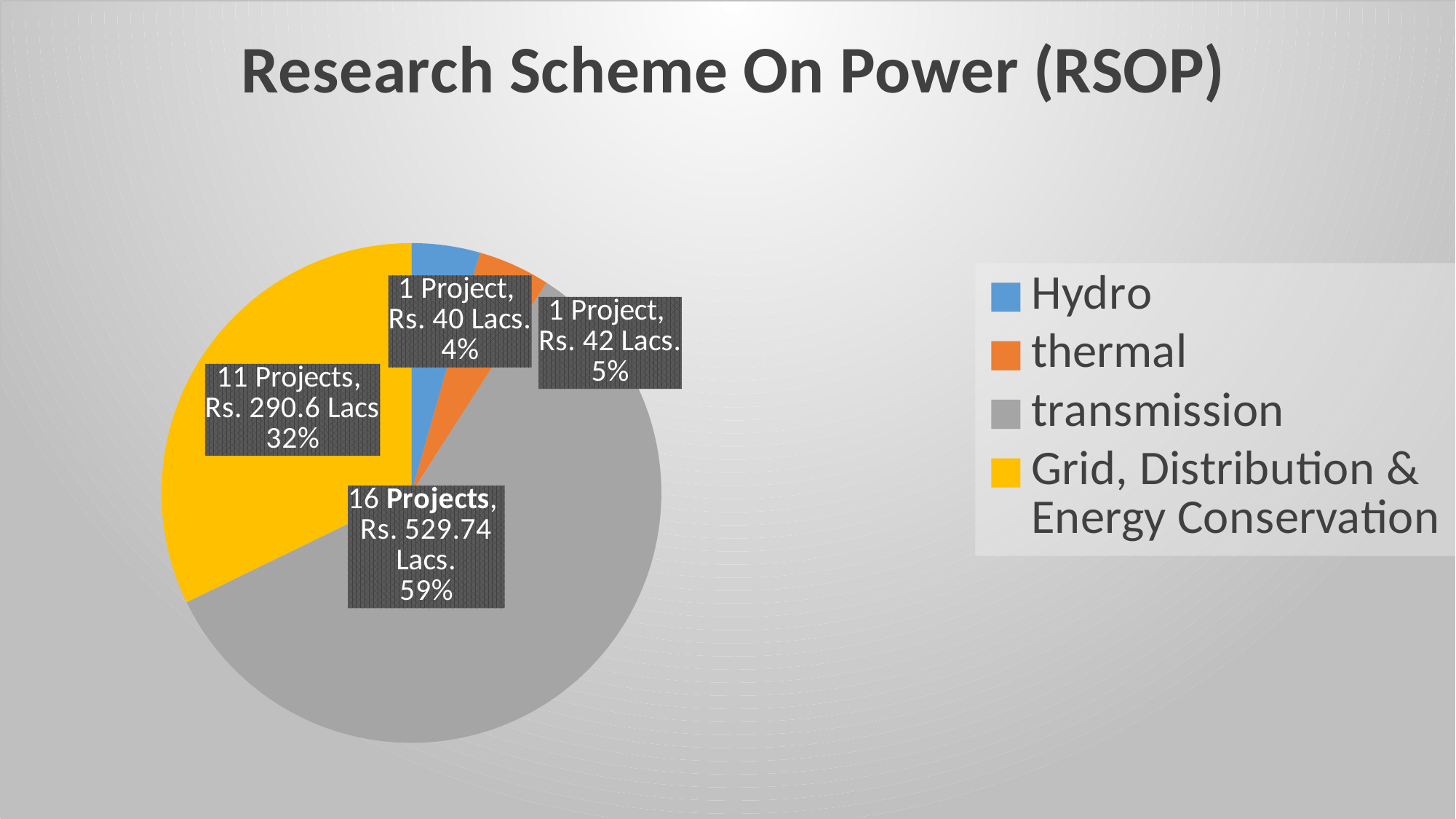
What is the title of the chart? Research Scheme On Power (RSOP) What kind of chart is shown on the slide? Pie chart What is the amount in Rs. Lacs for thermal? Rs. 42 Lacs. What share of the pie does Hydro represent? 4% What share of the pie does transmission represent? 59% Which category has the largest slice of the pie? transmission How many projects are there under transmission? 16 Projects What is the amount in Rs. Lacs for Grid, Distribution & Energy Conservation? Rs. 290.6 Lacs What share of the pie does Grid, Distribution & Energy Conservation represent? 32% Which category has the smallest slice of the pie? Hydro Which colour represents Grid, Distribution & Energy Conservation in the pie chart? Yellow How many categories does the legend list? 4